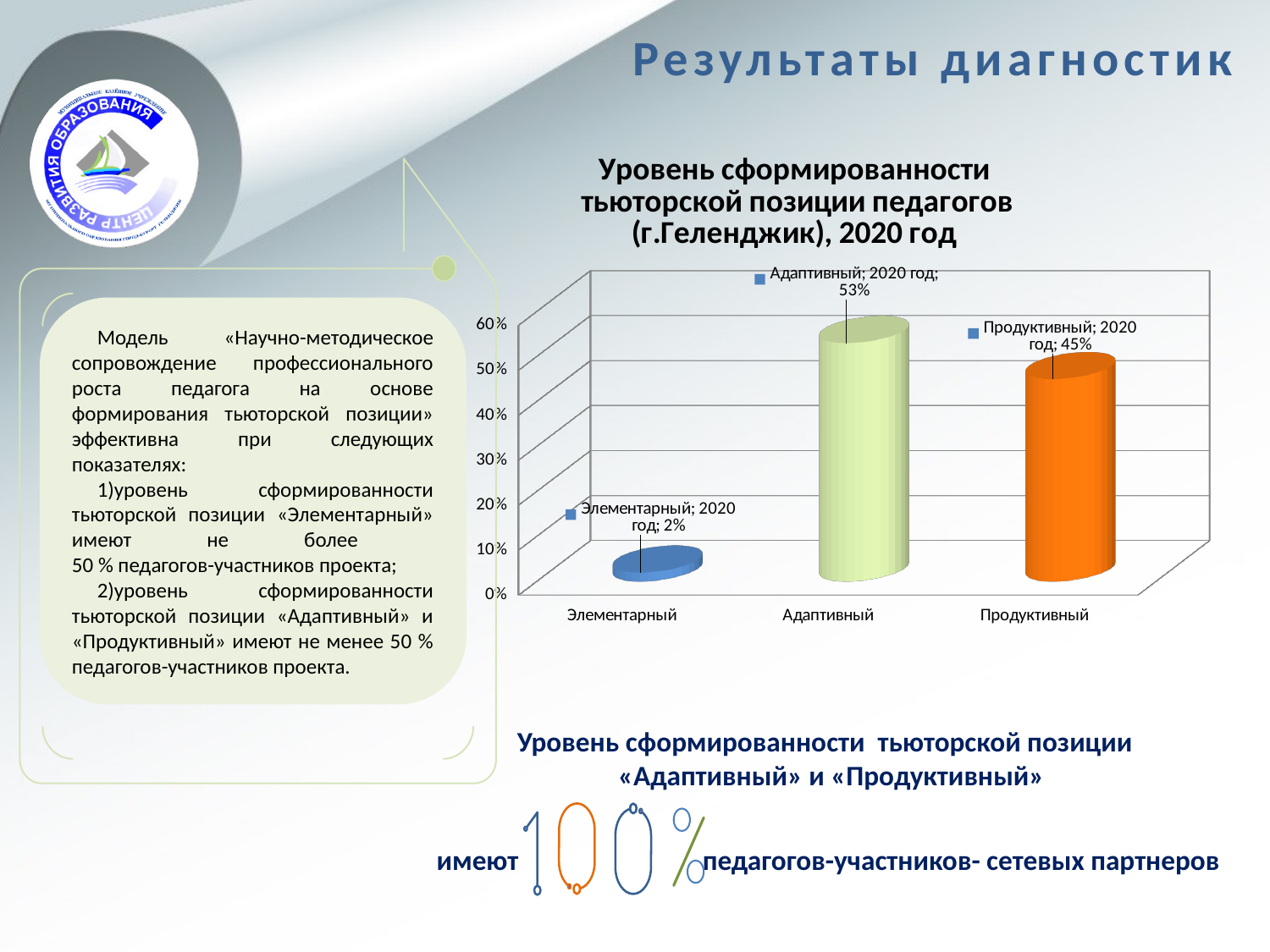
What kind of chart is shown on the slide? bar chart Which category has the lowest value in the chart? Элементарный What is the value for Адаптивный in the chart? 53% Is the value for Продуктивный greater or less than 40%? greater What is the difference between the values for Продуктивный and Элементарный? 43% What is the value for Продуктивный in the chart? 45% Which is larger, the value for Адаптивный or the value for Продуктивный? Адаптивный What is the difference between the values for Адаптивный and Продуктивный? 8% What is the title of the chart? Уровень сформированности тьюторской позиции педагогов (г.Геленджик), 2020 год Which category has the highest value in the chart? Адаптивный What is the value for Элементарный in the chart? 2% How many categories are shown on the x axis of the chart? 3